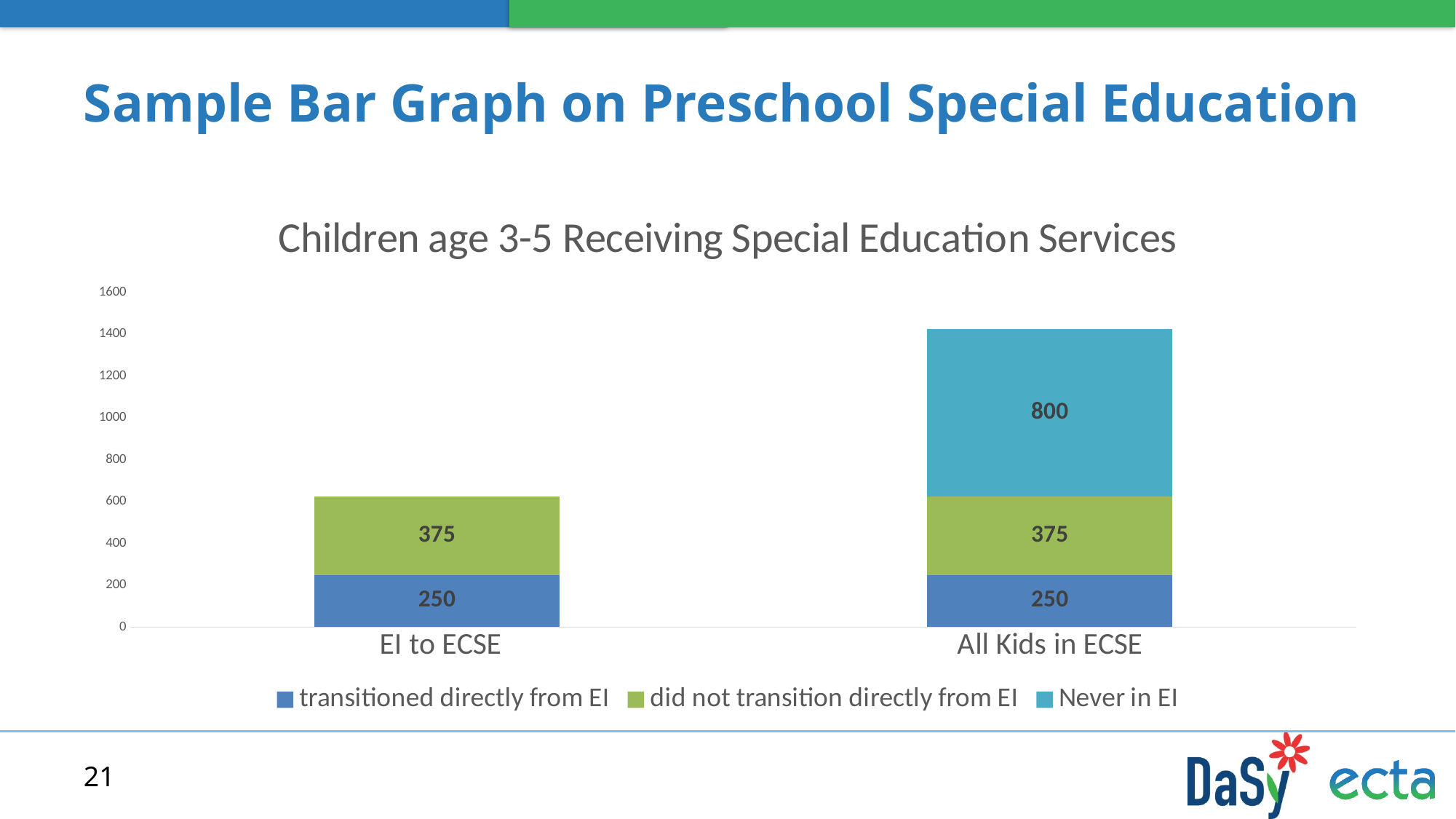
What is the difference between the 'Never in EI' value and the 'transitioned directly from EI' value in the 'All Kids in ECSE' bar? 550 What kind of chart is shown on the slide? Stacked bar chart What is the total of the 'EI to ECSE' stacked bar? 625 Which segment is largest in the 'All Kids in ECSE' bar? Never in EI What is the value for 'transitioned directly from EI' in the 'EI to ECSE' bar? 250 What is the value for 'did not transition directly from EI' in the 'All Kids in ECSE' bar? 375 How many categories are shown on the x axis? 2 How many series does the legend list? 3 Which segment is smallest in the 'EI to ECSE' bar? transitioned directly from EI Which bar has the larger total, 'EI to ECSE' or 'All Kids in ECSE'? All Kids in ECSE What is the total of the 'All Kids in ECSE' stacked bar? 1425 What is the value for 'Never in EI' in the 'All Kids in ECSE' bar? 800